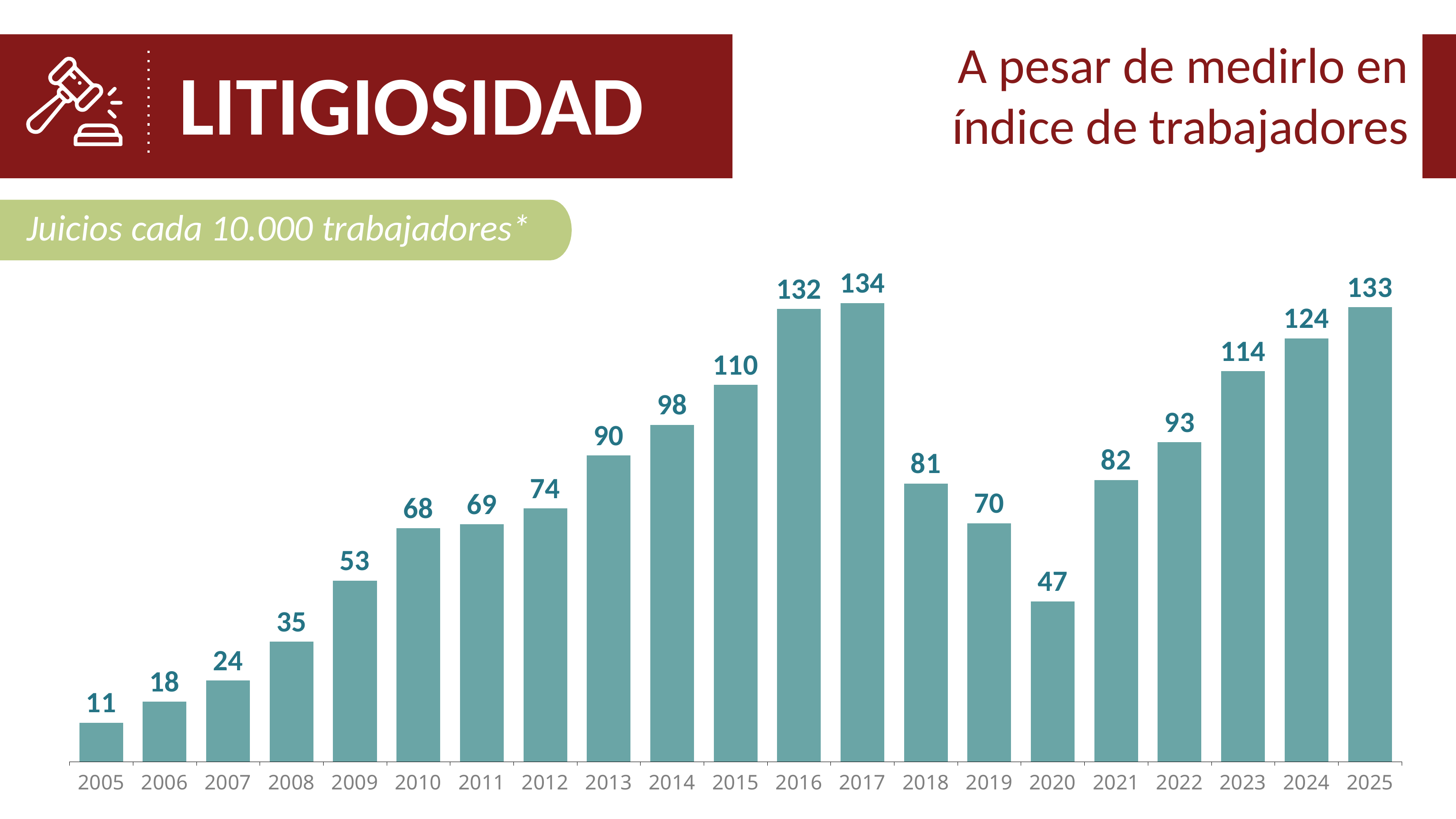
What is the value for 2005? 11 Which is larger, the value for 2016 or the value for 2025? 2025 What kind of chart is this? bar chart How many years are shown on the x axis? 21 What is the difference between the values for 2025 and 2024? 9 What is the subtitle label above the chart? Juicios cada 10.000 trabajadores* What is the value for 2020? 47 What is the difference between the values for 2017 and 2018? 53 Do the values rise or fall from 2005 to 2017? rise Which year has the highest value? 2017 What is the value for 2017? 134 Which year has the lowest value? 2005